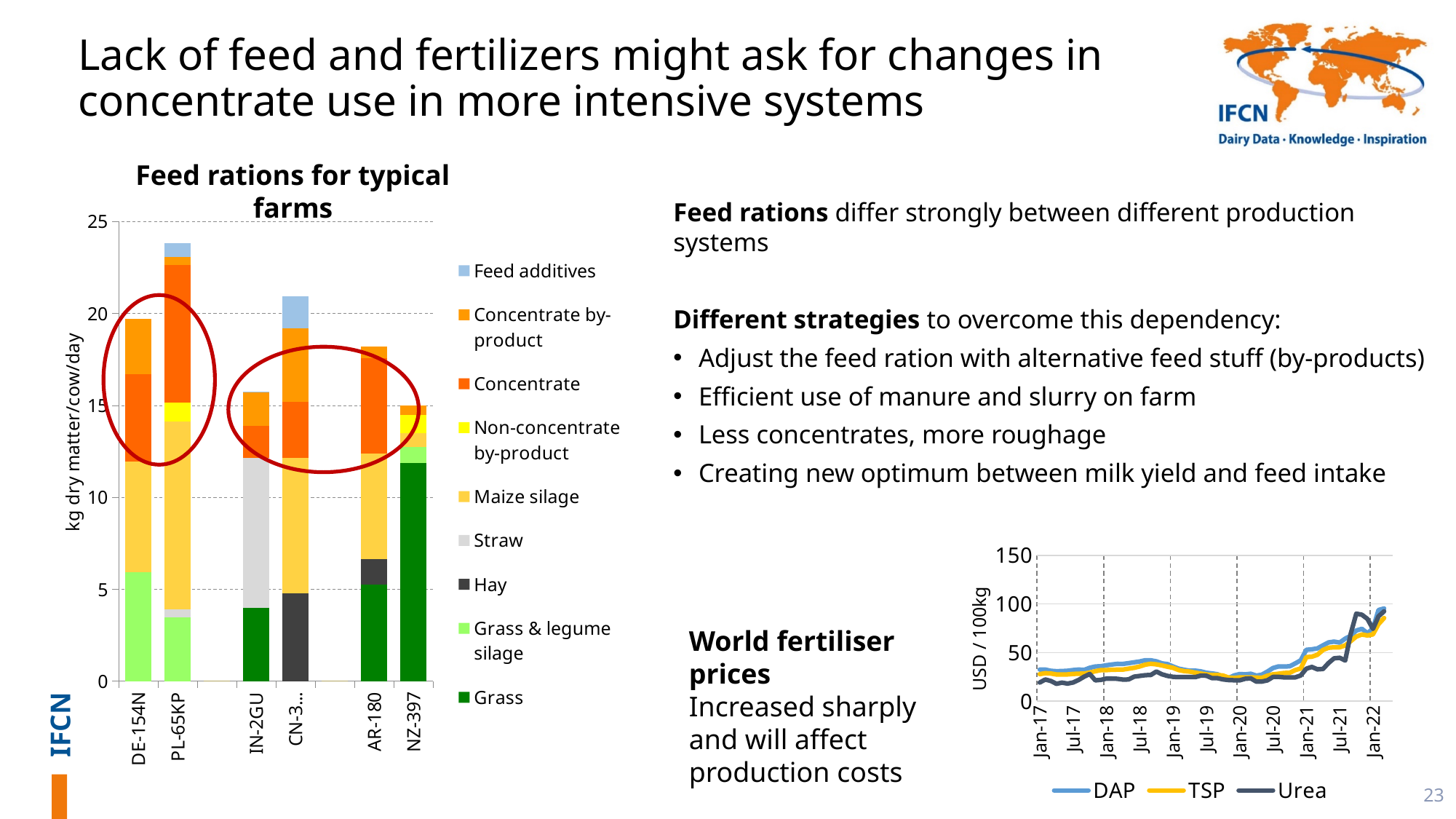
How many series does the legend of the world fertiliser prices chart list? 3 In the 'Feed rations for typical farms' chart, how many farms (bars) are shown? 6 In the 'Feed rations for typical farms' chart, is the total for AR-180 greater or less than 20? less In the 'Feed rations for typical farms' chart, is the total for DE-154N greater or less than 15? greater In the world fertiliser prices chart, is the DAP price at Jan-17 greater or less than 50 USD/100kg? less In the 'Feed rations for typical farms' chart, which farm has the highest total feed ration? PL-65KP In the 'Feed rations for typical farms' chart, which has the larger total feed ration, DE-154N or IN-2GU? DE-154N What type of chart is 'Feed rations for typical farms'? Stacked bar chart What type of chart is the world fertiliser prices chart at the bottom right? Line chart In the world fertiliser prices chart, do prices overall rise or fall from Jan-17 to Jan-22? Rise How many series does the legend of the 'Feed rations for typical farms' chart list? 9 What is the y-axis label of the 'Feed rations for typical farms' chart? kg dry matter/cow/day